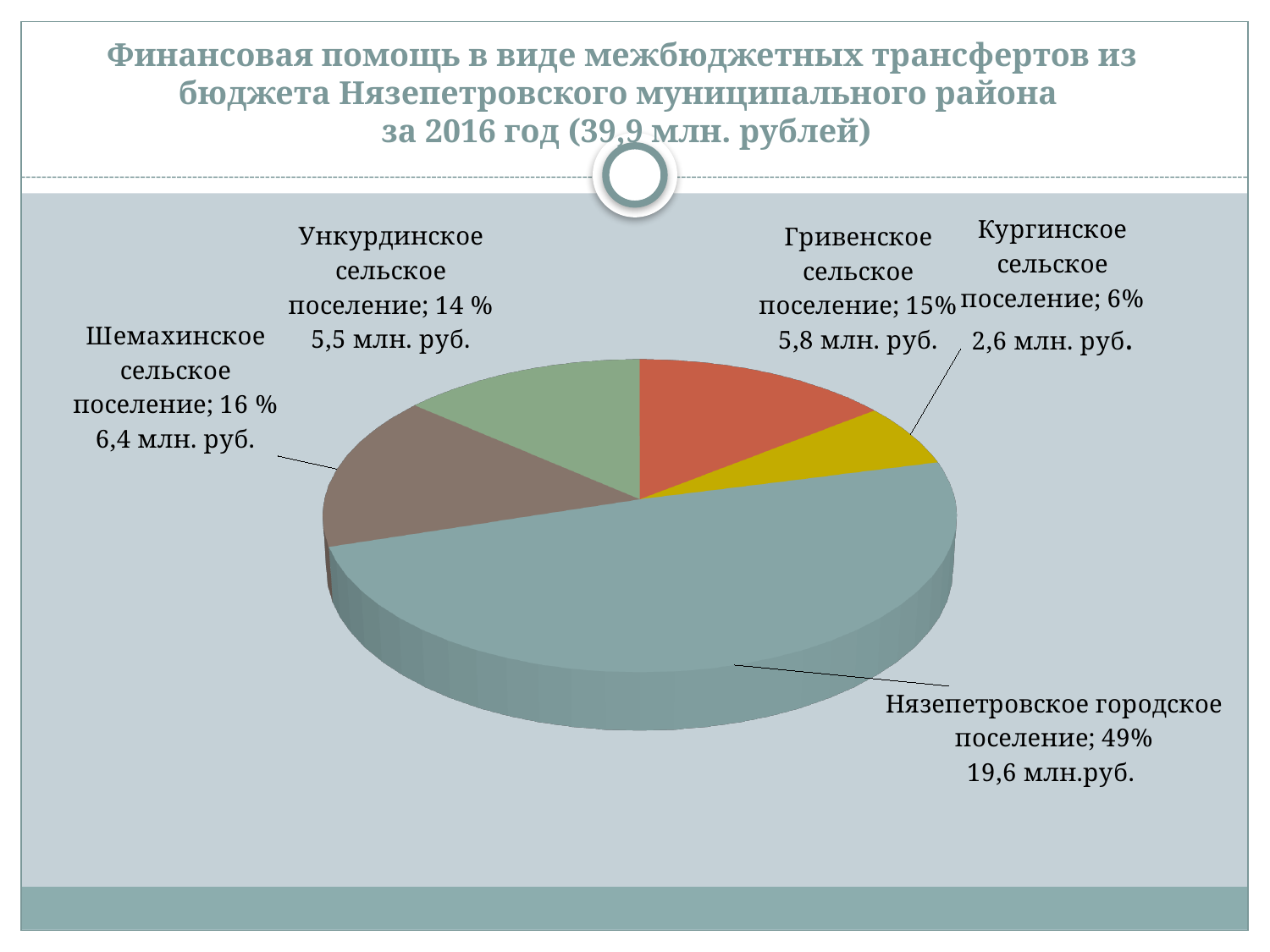
What share of the pie does Ункурдинское сельское поселение have? 14 % Which settlement received the largest amount of financial aid? Нязепетровское городское поселение What is the difference in млн. руб. between Нязепетровское городское поселение and Шемахинское сельское поселение? 13,2 млн. руб. How many slices does the pie chart have? 5 What is the difference in млн. руб. between Гривенское сельское поселение and Кургинское сельское поселение? 3,2 млн. руб. What is the value in млн. руб. for Шемахинское сельское поселение? 6,4 млн. руб. Which settlement received the smallest amount of financial aid? Кургинское сельское поселение Which received more: Гривенское сельское поселение or Ункурдинское сельское поселение? Гривенское сельское поселение What share of the pie does Нязепетровское городское поселение have? 49% What total amount of financial aid is stated in the chart title for 2016? 39,9 млн. рублей What is the value in млн. руб. for Кургинское сельское поселение? 2,6 млн. руб. What kind of chart is shown on the slide? Pie chart